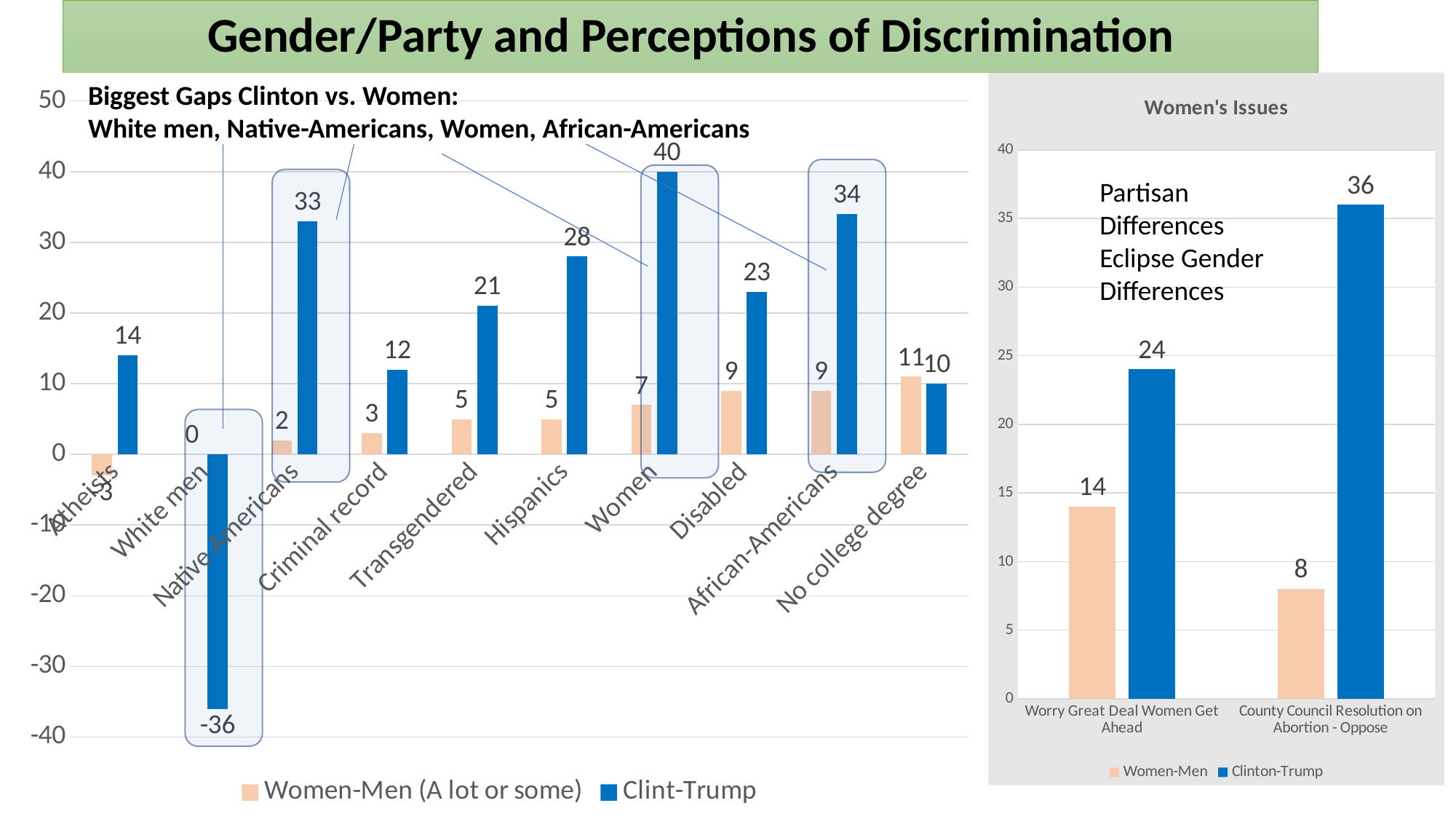
In the left chart, what is the difference between the Clint-Trump values for Native Americans and Criminal record? 21 In the left chart, what is the Clint-Trump value for Women? 40 In the left chart, what is the Clint-Trump value for White men? -36 In the Women's Issues chart, what is the Clinton-Trump value for County Council Resolution on Abortion - Oppose? 36 In the Women's Issues chart, what is the difference between the Clinton-Trump and Women-Men values for Worry Great Deal Women Get Ahead? 10 How many categories are shown on the x axis of the left chart? 10 In the left chart, what is the Women-Men (A lot or some) value for No college degree? 11 How many series does the legend of the Women's Issues chart list? 2 In the left chart, which category has the highest Clint-Trump value? Women In the left chart, which is larger for Hispanics: the Women-Men value or the Clint-Trump value? Clint-Trump In the left chart, which category has the lowest Clint-Trump value? White men What type of chart is the Women's Issues chart? Bar chart